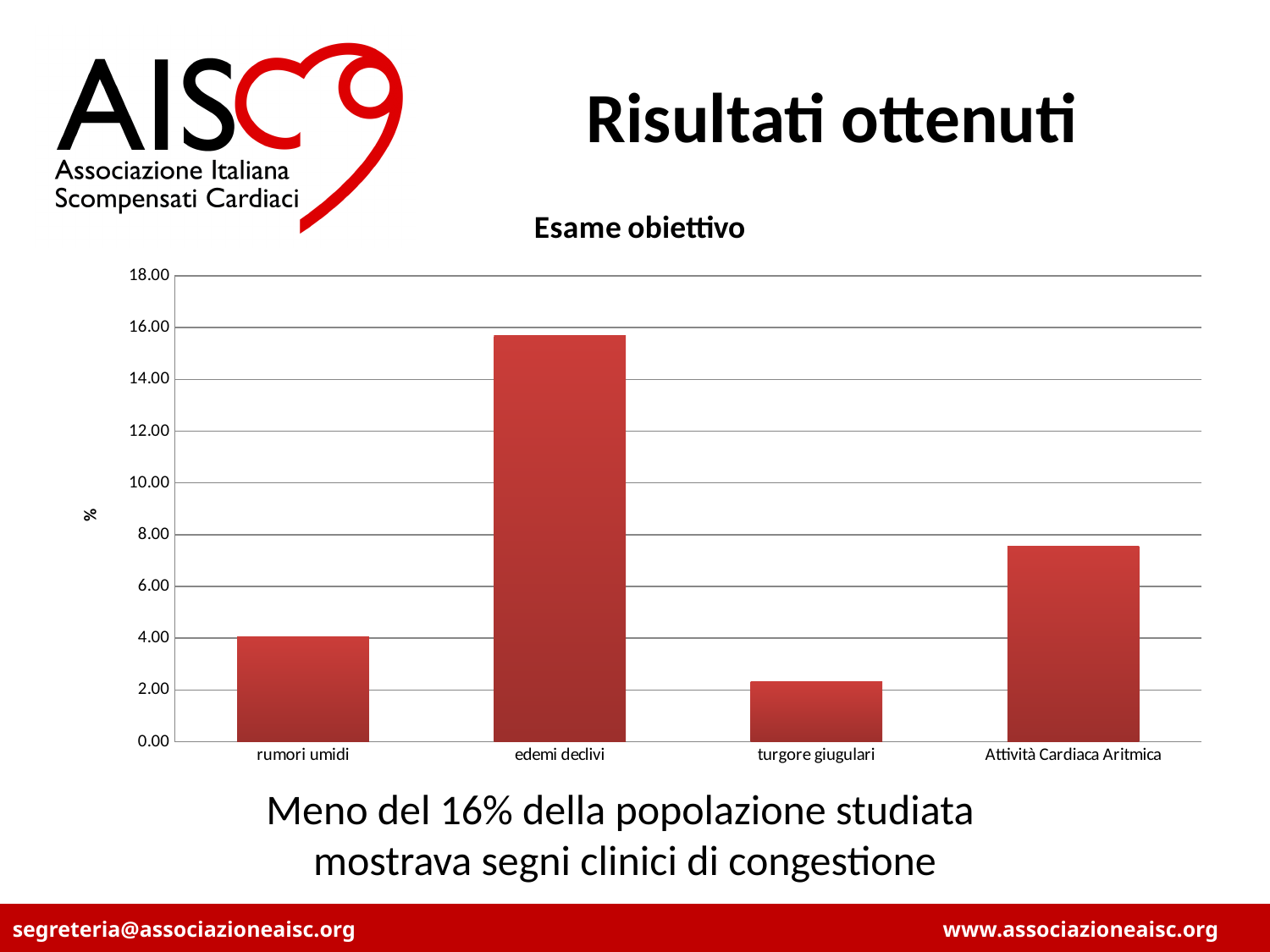
Which is larger, the value for rumori umidi or the value for Attività Cardiaca Aritmica? Attività Cardiaca Aritmica What kind of chart is shown on the slide? bar chart Is the value for edemi declivi greater or less than 16.00? less Which category has the highest value in the chart? edemi declivi What is the title of the chart? Esame obiettivo What is the label on the y axis of the chart? % Is the value for turgore giugulari greater or less than 4.00? less Which category has the lowest value in the chart? turgore giugulari Is the value for edemi declivi greater or less than 14.00? greater How many categories are shown on the x axis of the chart? 4 Which is larger, the value for edemi declivi or the value for turgore giugulari? edemi declivi